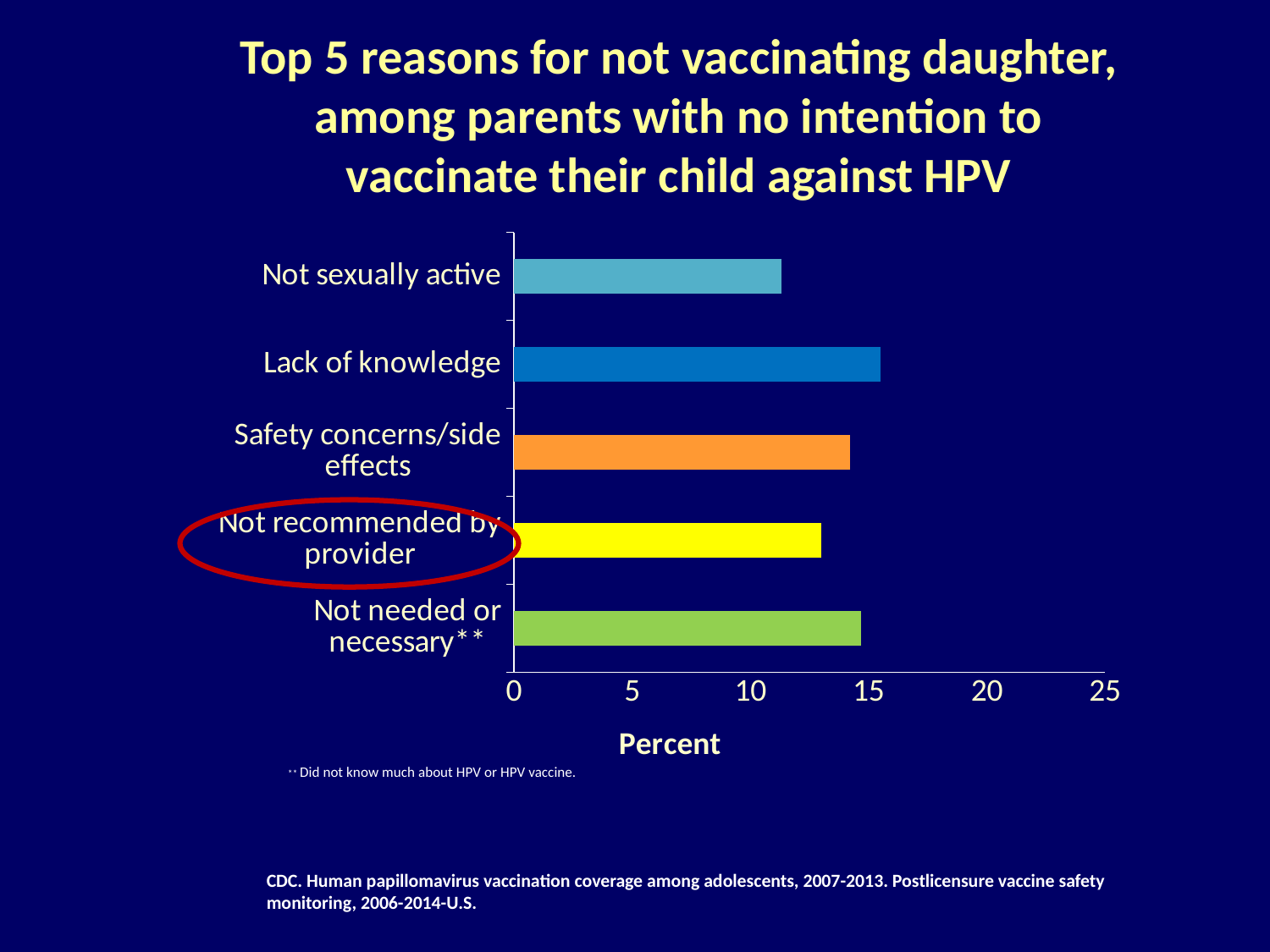
Is the value for "Not sexually active" greater or less than 15? less Which category label is circled in red on the slide? Not recommended by provider How many reasons (categories) are plotted in the chart? 5 What is the label on the horizontal axis of the chart? Percent What kind of chart is shown on the slide? bar chart Which reason has the highest percentage? Lack of knowledge Which reason has the lowest percentage? Not sexually active Is the value for "Not sexually active" greater or less than 10? greater Which is larger, the value for "Safety concerns/side effects" or the value for "Not recommended by provider"? Safety concerns/side effects Is the value for "Not recommended by provider" greater or less than 15? less Which is larger, the value for "Lack of knowledge" or the value for "Not sexually active"? Lack of knowledge